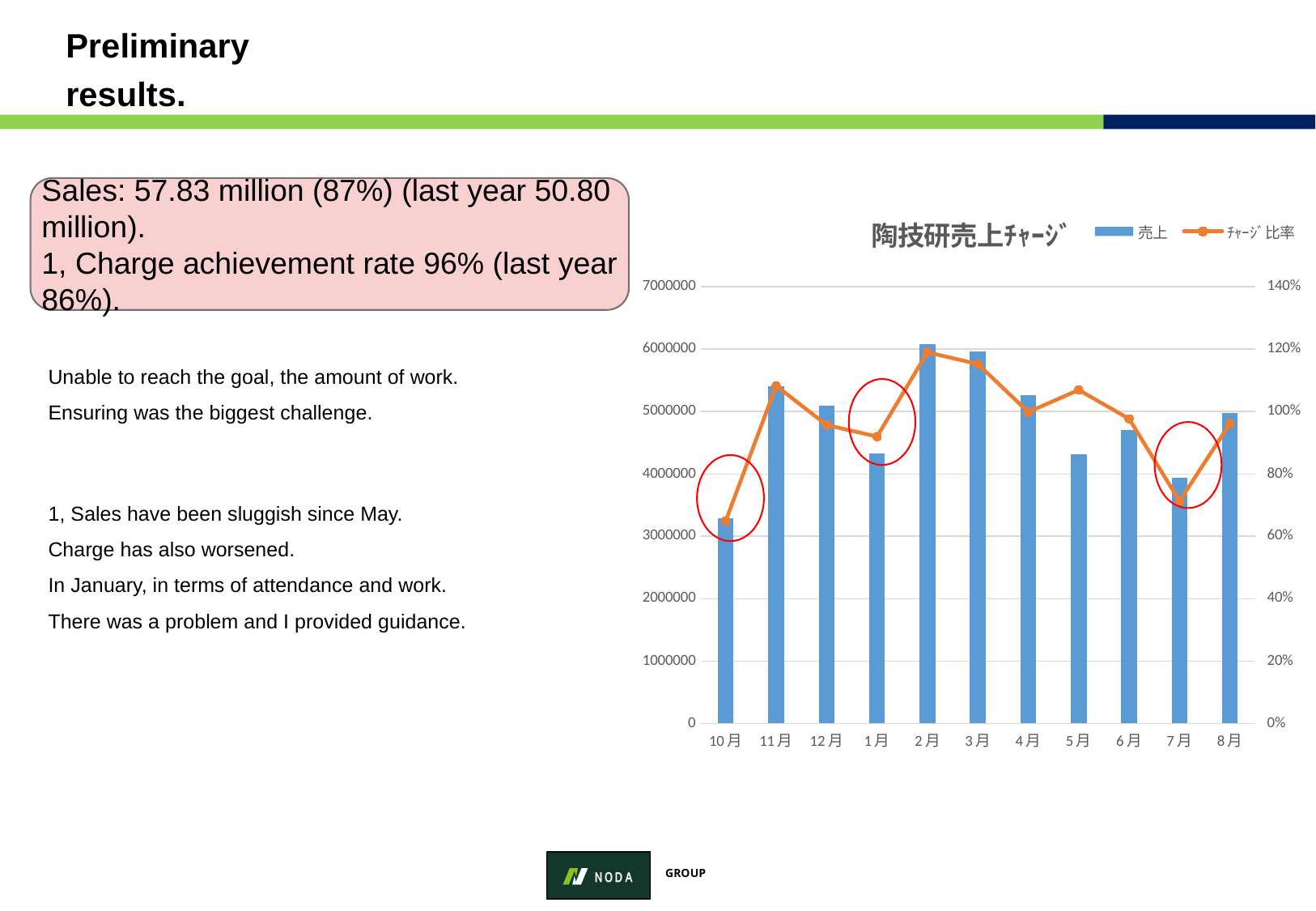
What type of chart is shown on the slide? Combination bar and line chart Is the ﾁｬｰｼﾞ比率 value for 2月 greater or less than 100%? greater Is the 売上 value for 5月 greater or less than 5000000? less How many months are shown on the x axis of the chart? 11 Does the 売上 bar rise or fall from 4月 to 5月? fall Is the 売上 value for 2月 greater or less than 6000000? greater Which month has the larger 売上 bar, 11月 or 10月? 11月 Which month has the highest 売上 (sales) bar? 2月 Which month has the lowest 売上 (sales) bar? 10月 How many series does the chart legend list? 2